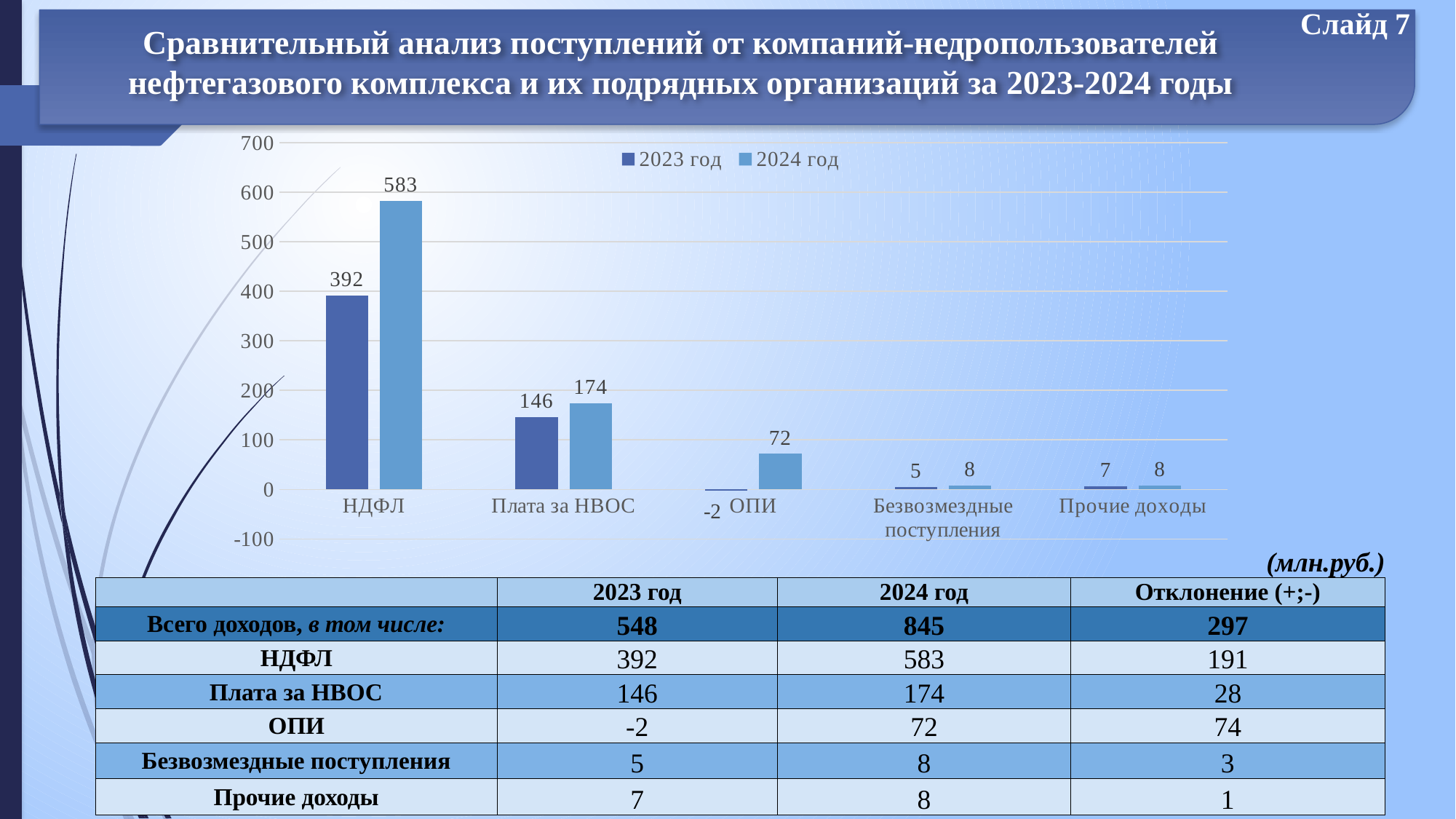
How many series does the chart legend list? 2 What is the difference between the 2024 год and 2023 год values for ОПИ? 74 What are the two series named in the chart legend? 2023 год and 2024 год What is the value for ОПИ in the 2023 год series? -2 Which is larger for Плата за НВОС: the 2023 год value or the 2024 год value? 2024 год What is the value for НДФЛ in the 2024 год series? 583 How many categories are shown on the x axis of the chart? 5 What is the difference between the 2024 год and 2023 год values for НДФЛ? 191 What kind of chart is shown on the slide? bar chart What is the value for Плата за НВОС in the 2023 год series? 146 Which category has the lowest value in the 2023 год series? ОПИ Which category has the highest value in the 2024 год series? НДФЛ